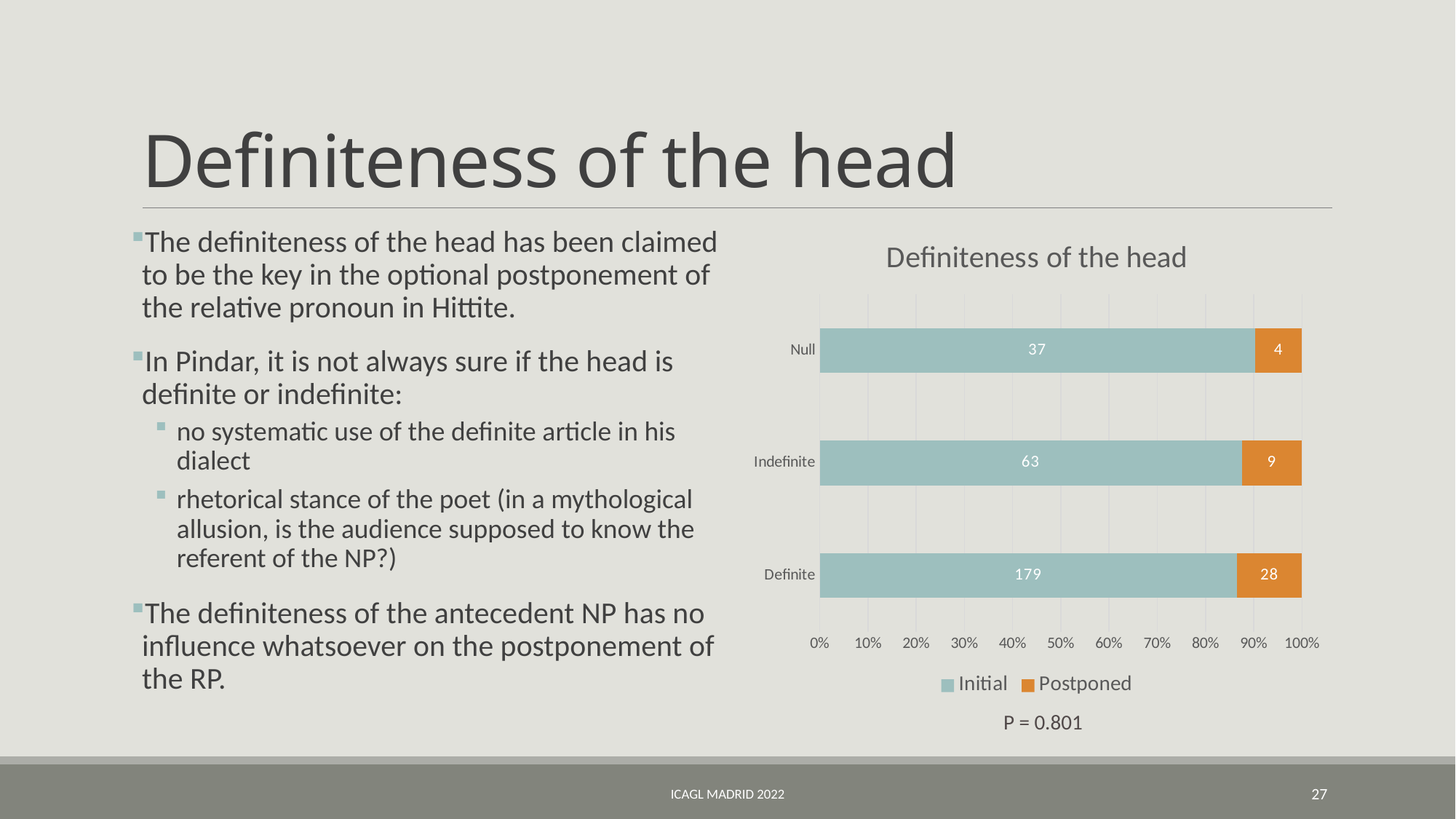
What is the difference between the Initial values for Indefinite and Null? 26 What is the Postponed value for the Null category? 4 What is the total of the Initial and Postponed values for the Definite bar? 207 Which is larger, the Postponed value for Definite or the Postponed value for Indefinite? Definite Which category has the highest Initial value? Definite What kind of chart is shown on the slide? Stacked bar chart What P value is printed below the chart? P = 0.801 What is the Initial value for the Definite category? 179 How many series does the legend list? 2 How many categories are shown on the chart? 3 What is the Postponed value for the Indefinite category? 9 Which category has the lowest Postponed value? Null